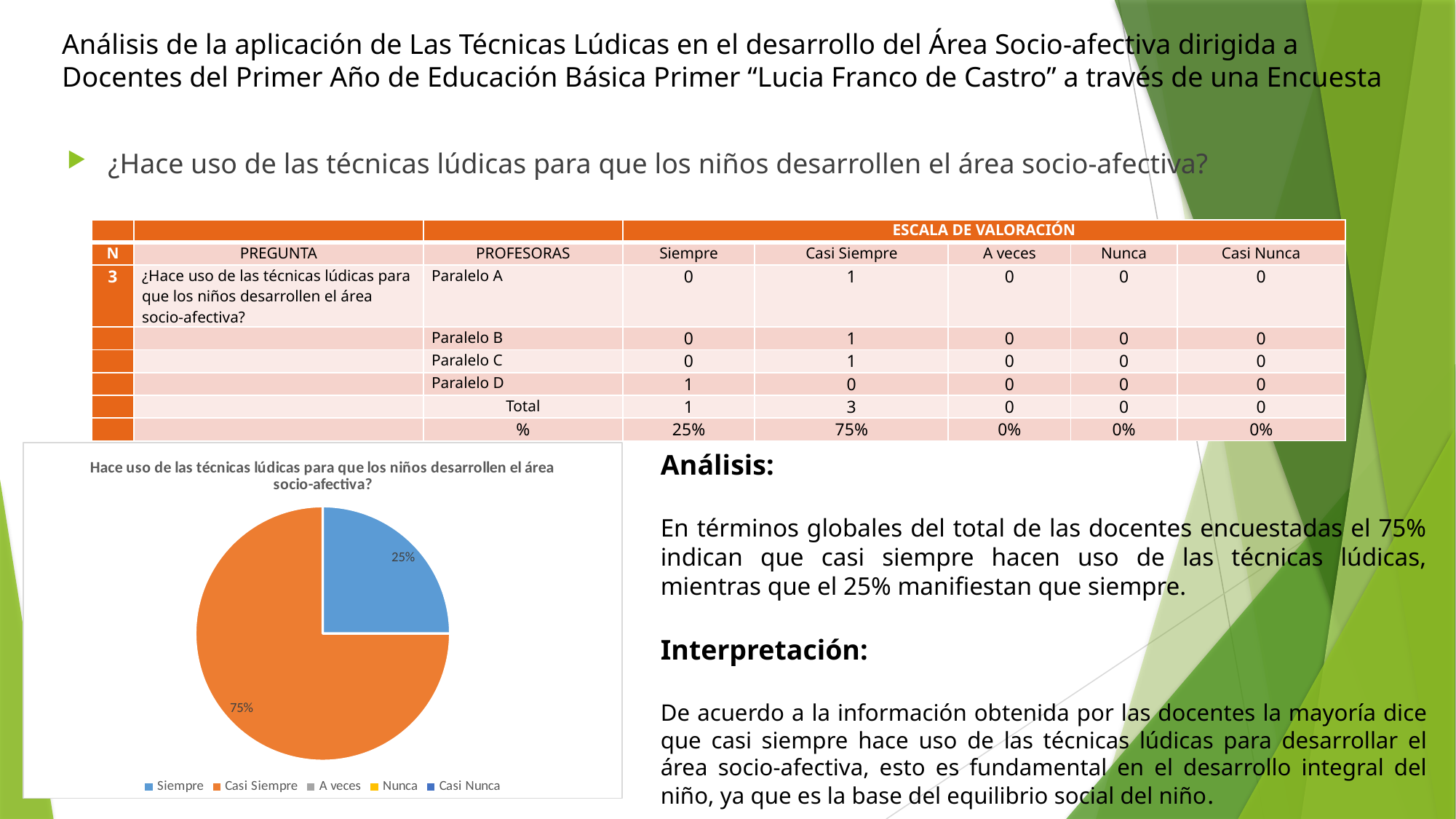
What share of the pie does the "Siempre" slice represent? 25% How many entries does the legend of the pie chart list? 5 What colour is the "Casi Siempre" slice in the pie chart? orange By how many percentage points does the "Casi Siempre" slice exceed the "Siempre" slice? 50 percentage points How many slices are visible in the pie chart? 2 What colour is the "Siempre" slice in the pie chart? blue Which is larger in the pie chart, the "Siempre" slice or the "Casi Siempre" slice? Casi Siempre What share of the pie does the "Casi Siempre" slice represent? 75% What kind of chart is shown on the slide? pie chart Which category has the largest slice in the pie chart? Casi Siempre Do the two labelled slices of the pie chart add up to 100%? yes